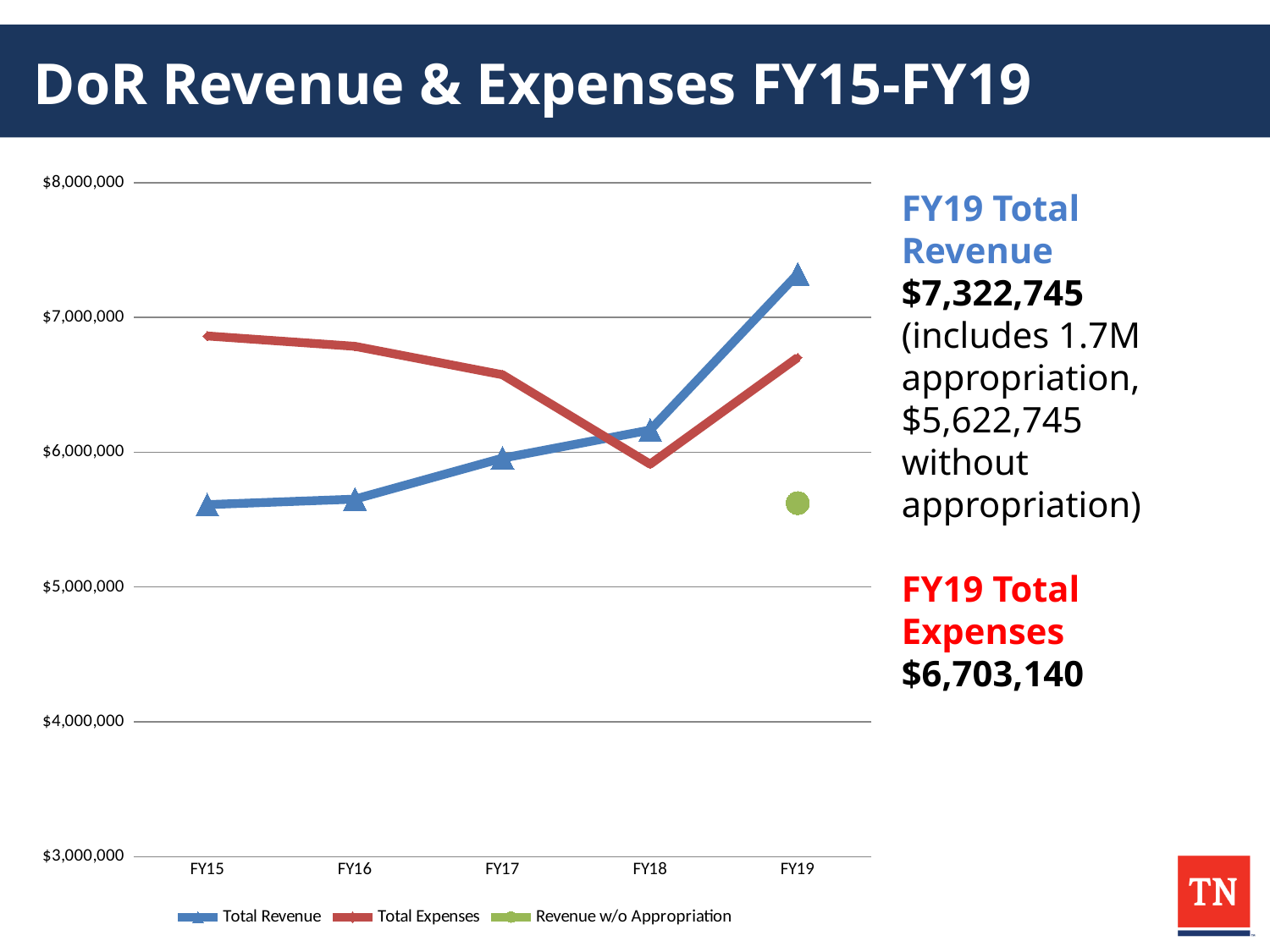
What is the FY19 Total Expenses value stated on the slide? $6,703,140 How many series does the chart legend list? 3 What is the difference between FY19 Total Revenue and FY19 Total Expenses? $619,605 Is the Total Expenses value for FY15 greater or less than $6,000,000? greater How many fiscal years are plotted on the x axis? 5 What is the FY19 Total Revenue value stated on the slide? $7,322,745 In which fiscal year is Total Revenue highest? FY19 In FY15, which is larger: Total Revenue or Total Expenses? Total Expenses Does Total Revenue rise or fall from FY15 to FY19? Rise What is the FY19 revenue without appropriation, as stated on the slide? $5,622,745 In which fiscal year is Total Expenses lowest? FY18 What type of chart is shown on the slide? Line chart